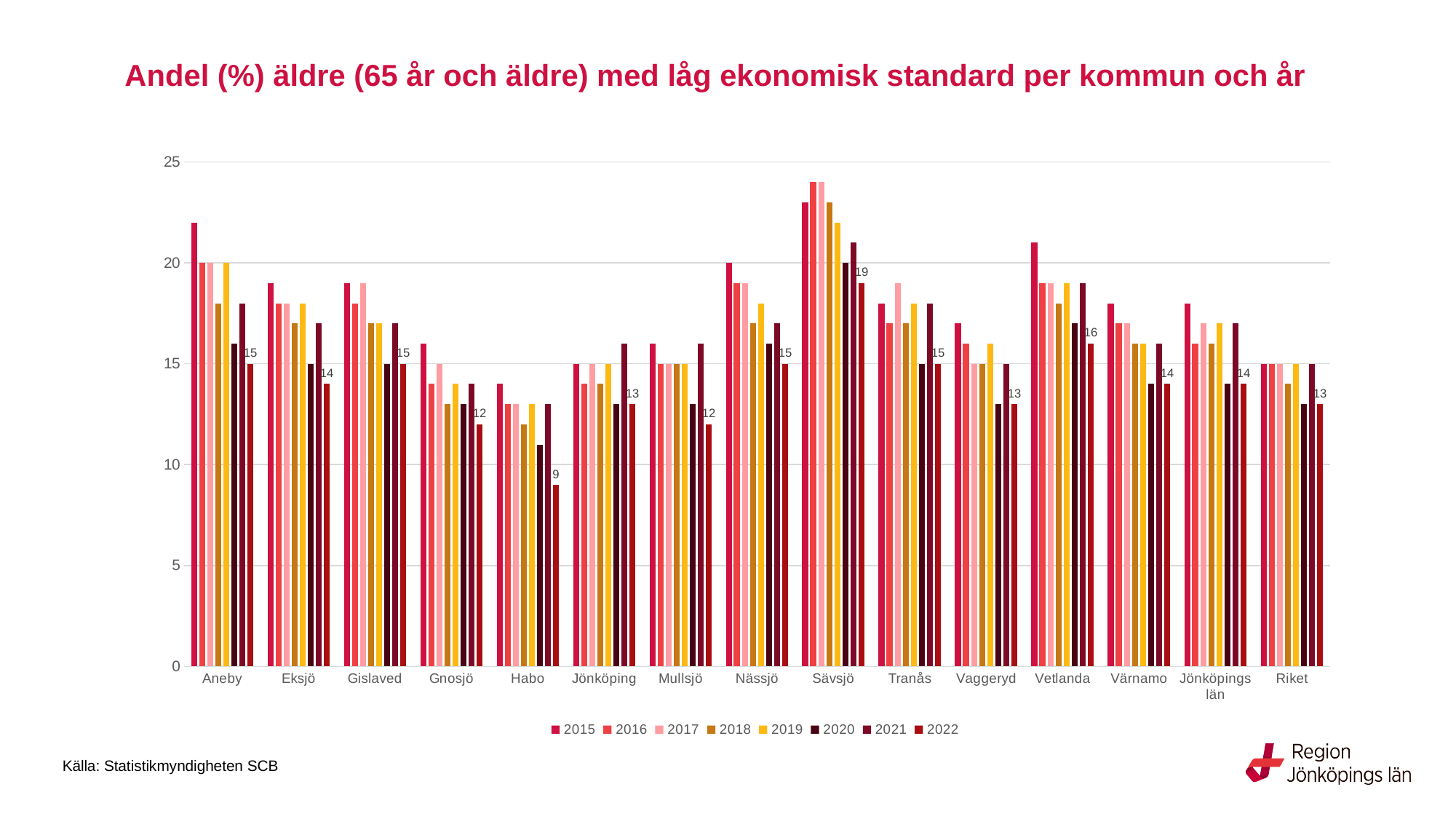
Is the value for Sävsjö in 2016 greater or less than 20? greater Which municipality has the lowest value in 2022? Habo What is the difference between the 2022 values for Sävsjö and Habo? 10 How many categories are shown on the x axis? 15 What kind of chart is shown on the slide? Bar chart Is the value for Habo in 2015 greater or less than 15? less What is the value for Habo in 2022? 9 What is the value for Sävsjö in 2022? 19 Which municipality has the highest value in 2022? Sävsjö Which has the larger 2022 value, Vetlanda or Gnosjö? Vetlanda How many series does the legend list? 8 What is the value for Riket in 2022? 13